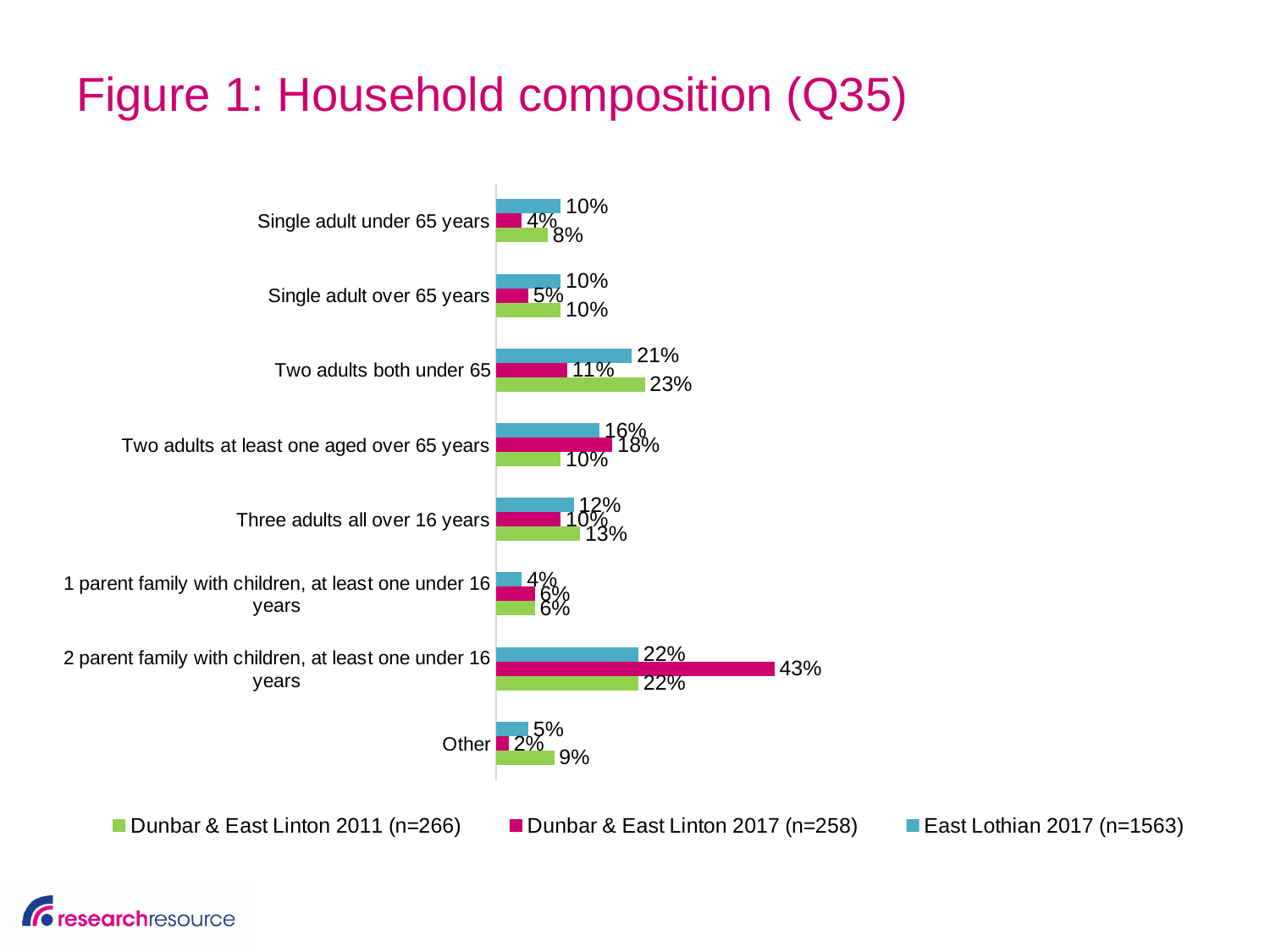
What kind of chart is shown on the slide? Bar chart Which series is shown in green in the legend? Dunbar & East Linton 2011 (n=266) How many series does the legend list? 3 Which category has the highest value for Dunbar & East Linton 2017 (n=258)? 2 parent family with children, at least one under 16 years Which category has the lowest value for Dunbar & East Linton 2017 (n=258)? Other What is the value for Dunbar & East Linton 2017 (n=258) for 'Single adult under 65 years'? 4% What is the value for Dunbar & East Linton 2017 (n=258) for '2 parent family with children, at least one under 16 years'? 43% What is the value for Dunbar & East Linton 2011 (n=266) for 'Other'? 9% For 'Two adults both under 65', which is larger: Dunbar & East Linton 2011 (n=266) or Dunbar & East Linton 2017 (n=258)? Dunbar & East Linton 2011 (n=266) What is the difference between the Dunbar & East Linton 2017 (n=258) and Dunbar & East Linton 2011 (n=266) values for '2 parent family with children, at least one under 16 years'? 21% What is the value for East Lothian 2017 (n=1563) for 'Two adults both under 65'? 21% How many household composition categories are shown on the chart? 8